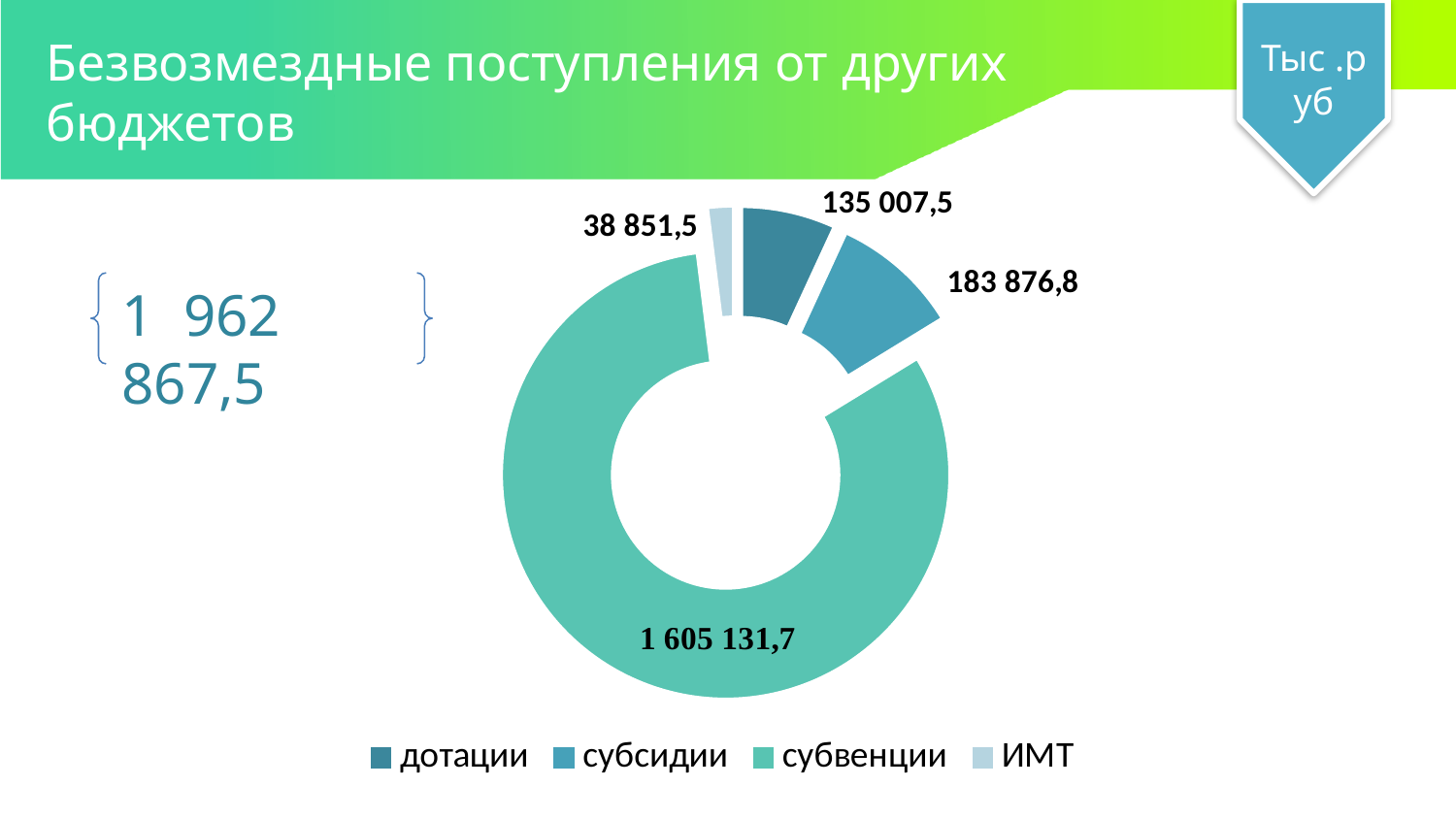
What is the value for субвенции in the doughnut chart? 1 605 131,7 What is the value for ИМТ in the doughnut chart? 38 851,5 What is the value for субсидии in the doughnut chart? 183 876,8 Which category has the smallest value in the doughnut chart? ИМТ Which is larger, субсидии or дотации? субсидии What is the difference between дотации and ИМТ? 96 156,0 Which category has the largest value in the doughnut chart? субвенции What is the difference between субсидии and дотации? 48 869,3 What is the title of the slide containing the chart? Безвозмездные поступления от других бюджетов How many categories does the doughnut chart show? 4 What kind of chart is shown on the slide? doughnut chart What is the value for дотации in the doughnut chart? 135 007,5